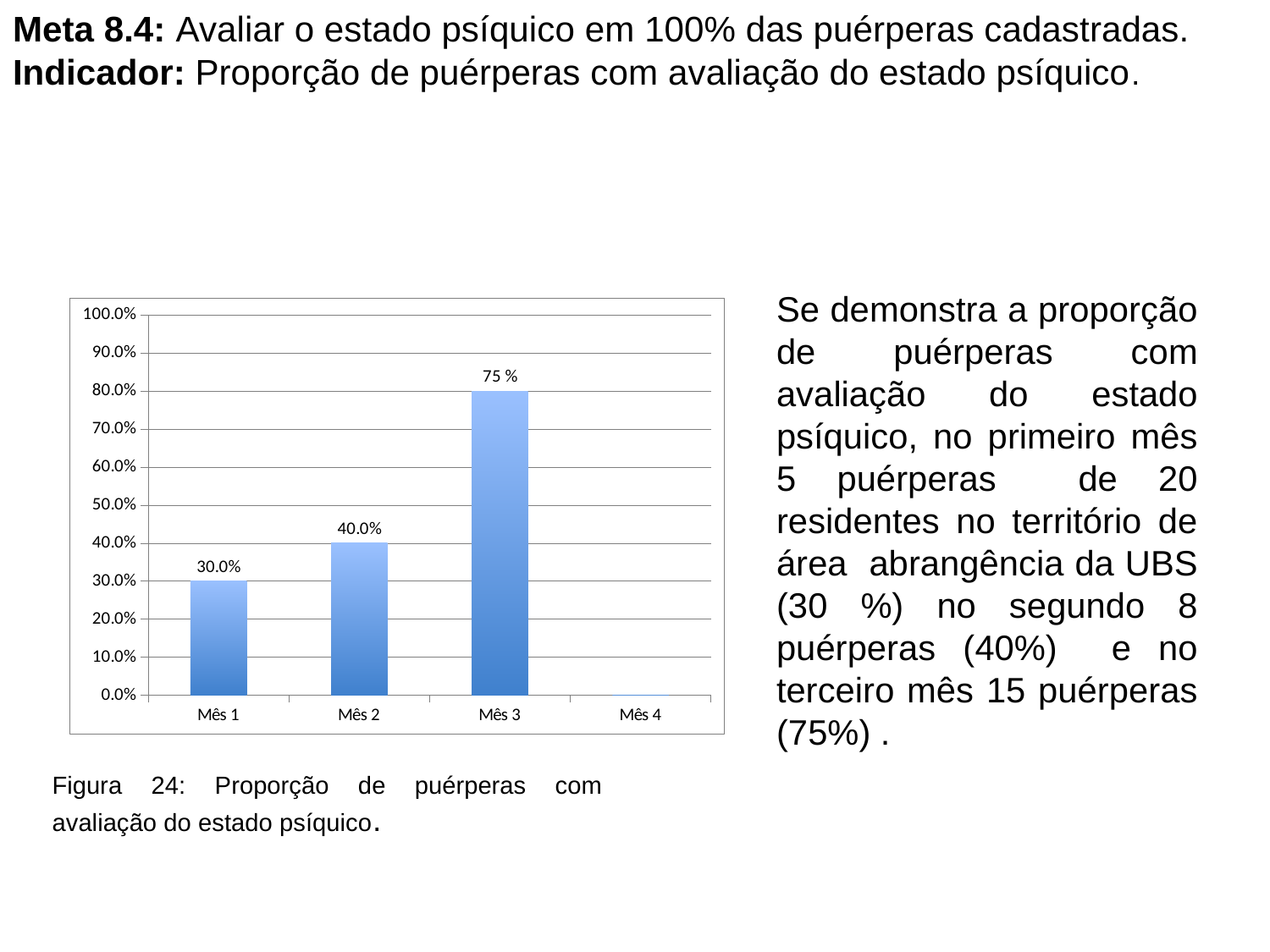
What is the value shown for Mês 1? 30.0% Which month with a plotted bar has the lowest value? Mês 1 Is the value for Mês 3 greater or less than 70.0%? greater What is the difference between the values for Mês 2 and Mês 1? 10.0% Which is larger, the value for Mês 1 or the value for Mês 2? Mês 2 What is the maximum value shown on the y axis? 100.0% What is the value shown for Mês 2? 40.0% Do the values rise or fall from Mês 1 to Mês 3? Rise How many month categories are shown on the x axis? 4 What kind of chart is shown on the slide? Bar chart What data label is shown above the bar for Mês 3? 75 % Which month has the highest bar? Mês 3